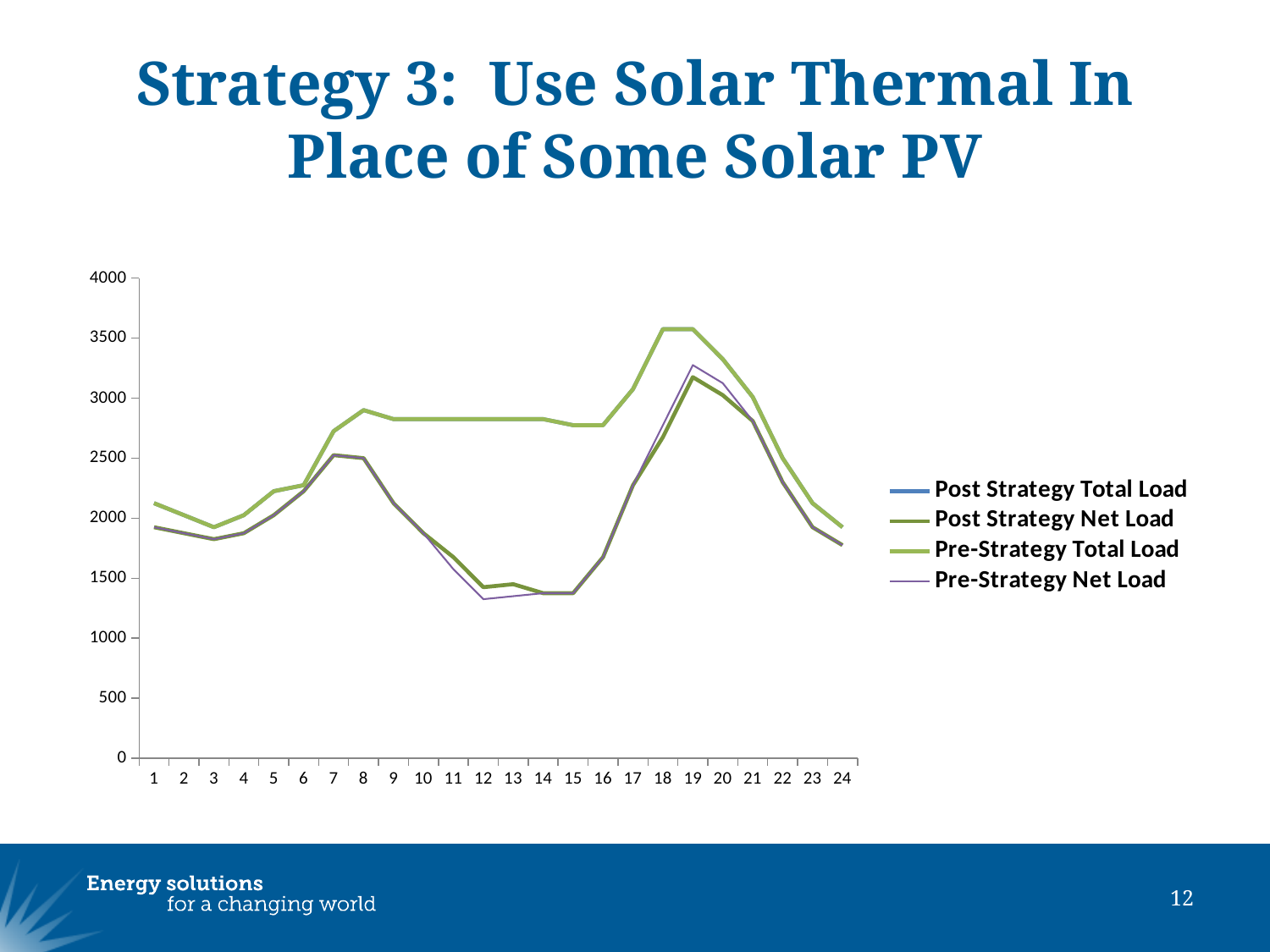
Is the value of Pre-Strategy Net Load at hour 19 greater or less than 3000? greater Is the value of Post Strategy Net Load at hour 12 greater or less than 1500? less What colour is the Pre-Strategy Total Load line in the legend? green Does the Pre-Strategy Total Load rise or fall from hour 19 to hour 24? fall At hour 12, which is larger: Pre-Strategy Total Load or Post Strategy Net Load? Pre-Strategy Total Load Is the value of Pre-Strategy Total Load at hour 12 greater or less than 2500? greater At hour 19, which is larger: Pre-Strategy Net Load or Post Strategy Net Load? Pre-Strategy Net Load How many points are plotted along the x axis for each series? 24 How many series does the chart legend list? 4 What kind of chart is shown on the slide? line chart